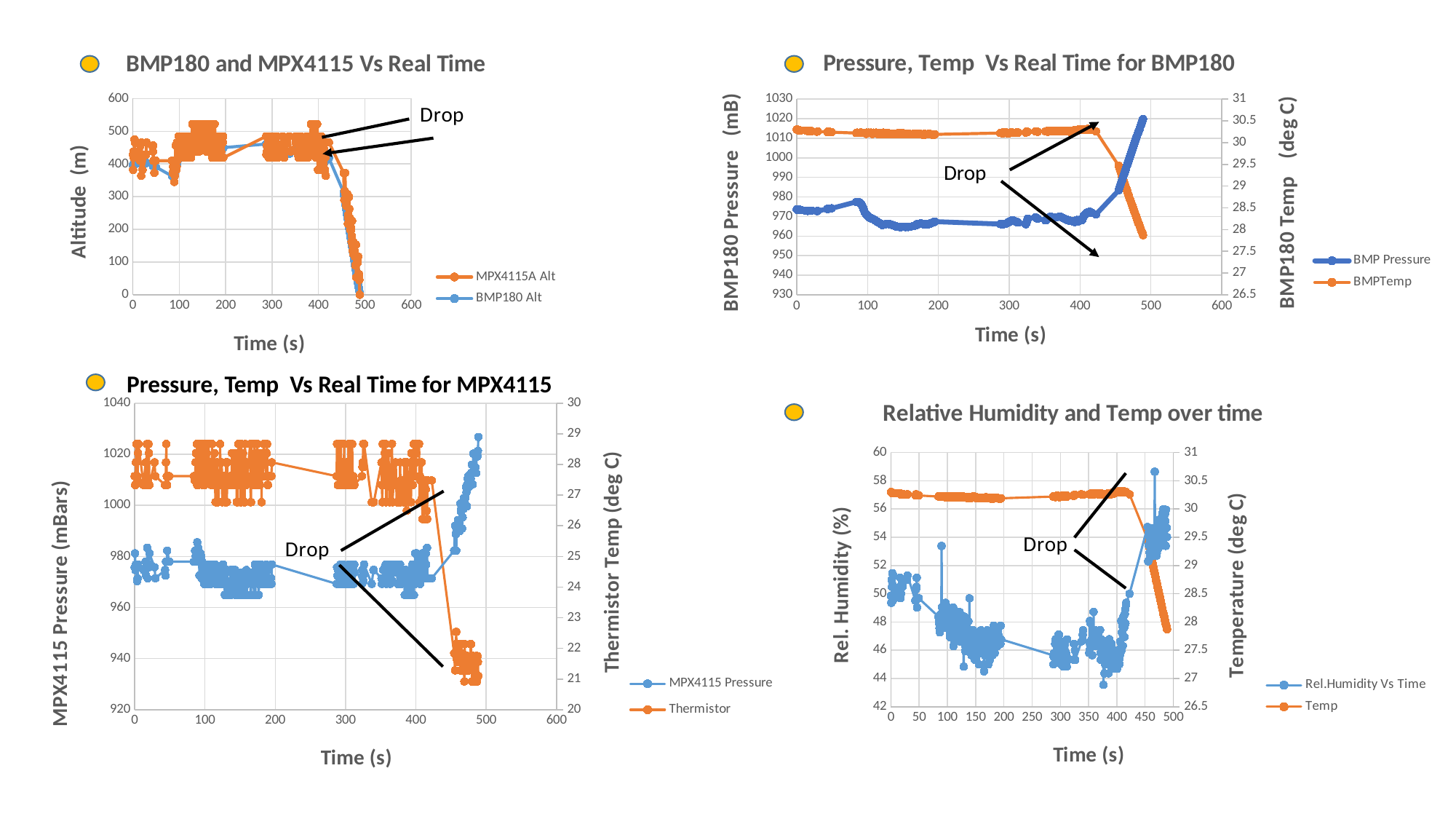
In the chart titled "Relative Humidity and Temp over time", is the relative humidity at time 0 greater or less than 48%? greater In the chart titled "BMP180 and MPX4115 Vs Real Time", how many series does the legend list? 2 In the chart titled "BMP180 and MPX4115 Vs Real Time", what are the two series named in the legend? MPX4115A Alt and BMP180 Alt In the chart titled "Pressure, Temp Vs Real Time for BMP180", is the BMP Pressure value at time 0 greater or less than 980? less In the chart titled "Pressure, Temp Vs Real Time for MPX4115", how many series does the legend list? 2 What kind of chart is the "Relative Humidity and Temp over time" chart? line chart In the chart titled "Pressure, Temp Vs Real Time for BMP180", does the BMPTemp series rise or fall after about 430 s? fall How many charts are shown on the slide? 4 In the chart titled "BMP180 and MPX4115 Vs Real Time", does the altitude rise or fall between 400 s and 500 s? fall In the chart titled "Pressure, Temp Vs Real Time for BMP180", what is the label of the left vertical axis? BMP180 Pressure (mB) In the chart titled "BMP180 and MPX4115 Vs Real Time", is the altitude at time 0 greater or less than 300 m? greater In the chart titled "Pressure, Temp Vs Real Time for MPX4115", does the MPX4115 Pressure series rise or fall between 430 s and 490 s? rise